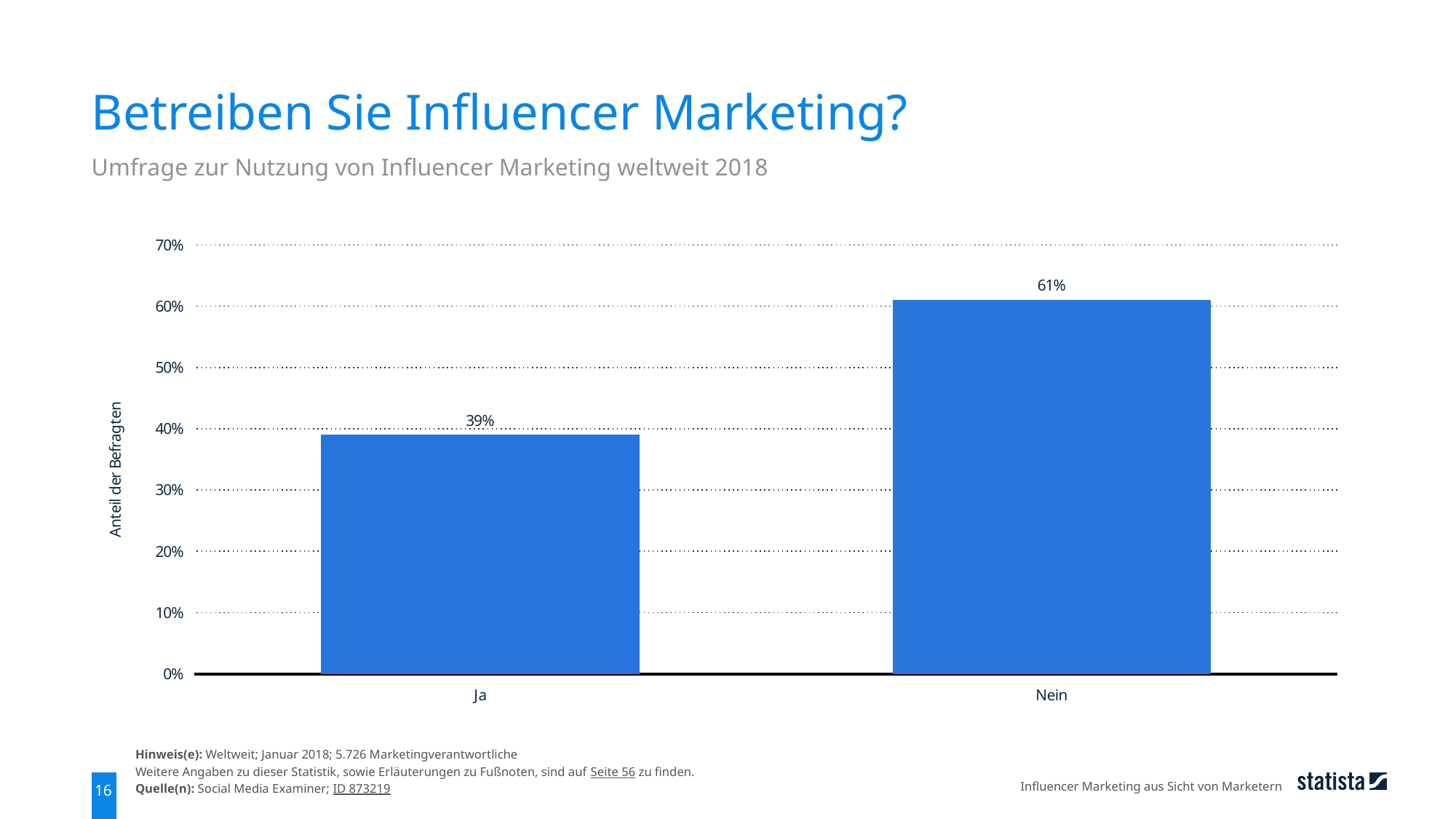
Is the value for "Nein" greater or less than 50%? greater What is the title of the chart? Betreiben Sie Influencer Marketing? Which is larger, the value for "Ja" or the value for "Nein"? Nein Which category has the highest value? Nein Which category has the lowest value? Ja How many categories are shown on the x axis? 2 What kind of chart is shown on the slide? Bar chart What is the difference between the values for "Nein" and "Ja"? 22% What is the value for "Nein"? 61% What is the label of the y axis? Anteil der Befragten What is the value for "Ja"? 39% Is the value for "Ja" greater or less than 40%? less